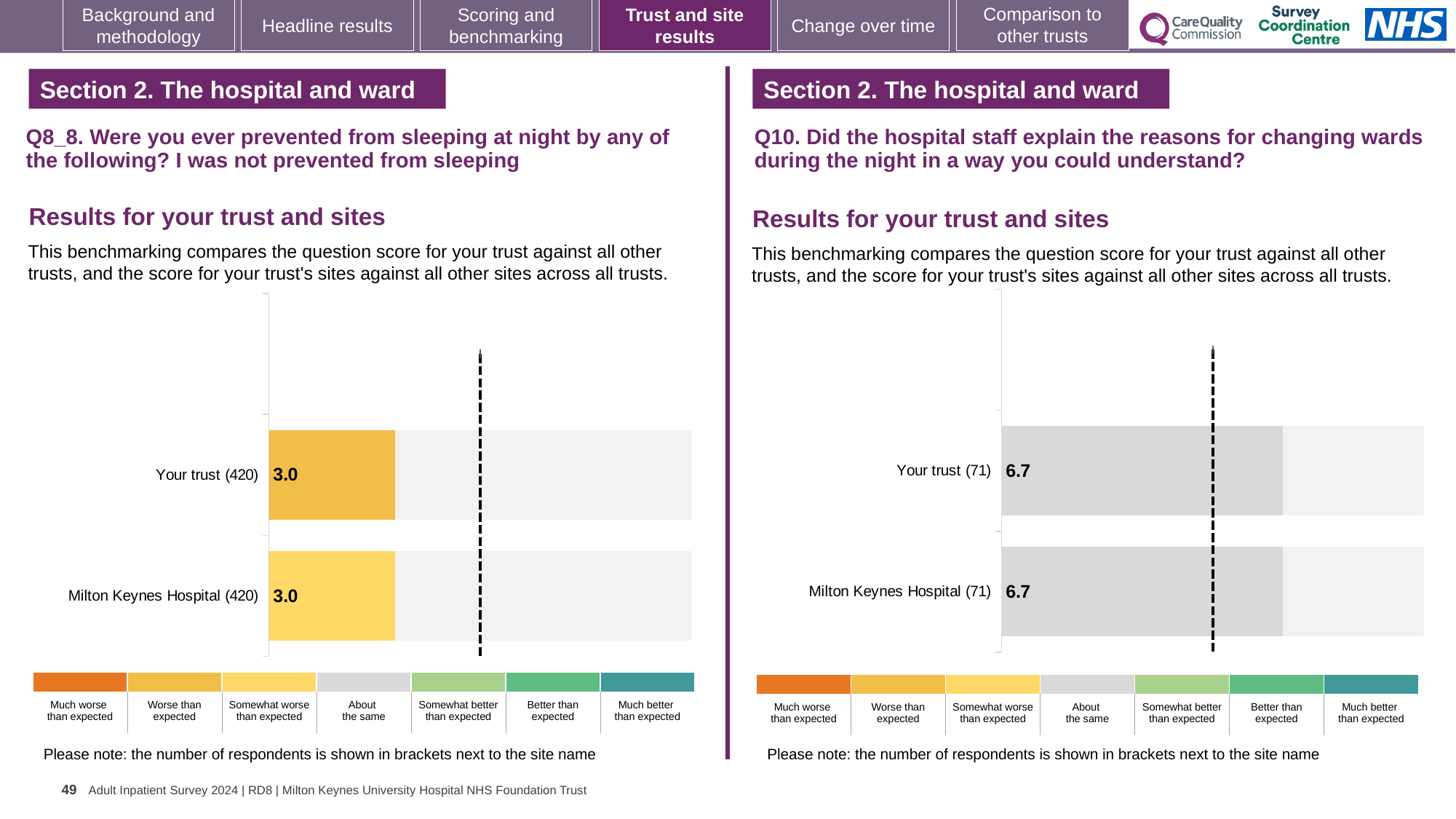
On the right chart (Q10), what is the score for Your trust? 6.7 Which chart shows the higher score for Your trust, the left chart (Q8_8) or the right chart (Q10)? The right chart (Q10) On the left chart (Q8_8), what is the score for Your trust? 3.0 On the left chart (Q8_8), what is the score for Milton Keynes Hospital? 3.0 On the right chart (Q10), how many respondents are shown in brackets for Milton Keynes Hospital? 71 How many bars are plotted on the right chart (Q10)? 2 How many bars are plotted on the left chart (Q8_8)? 2 On the right chart (Q10), what is the difference between the score for Your trust and the score for Milton Keynes Hospital? 0.0 On the right chart (Q10), what is the score for Milton Keynes Hospital? 6.7 On the left chart (Q8_8), how many respondents are shown in brackets for Your trust? 420 On the left chart (Q8_8), what is the difference between the score for Your trust and the score for Milton Keynes Hospital? 0.0 What kind of chart is used on the left (Q8_8)? Bar chart